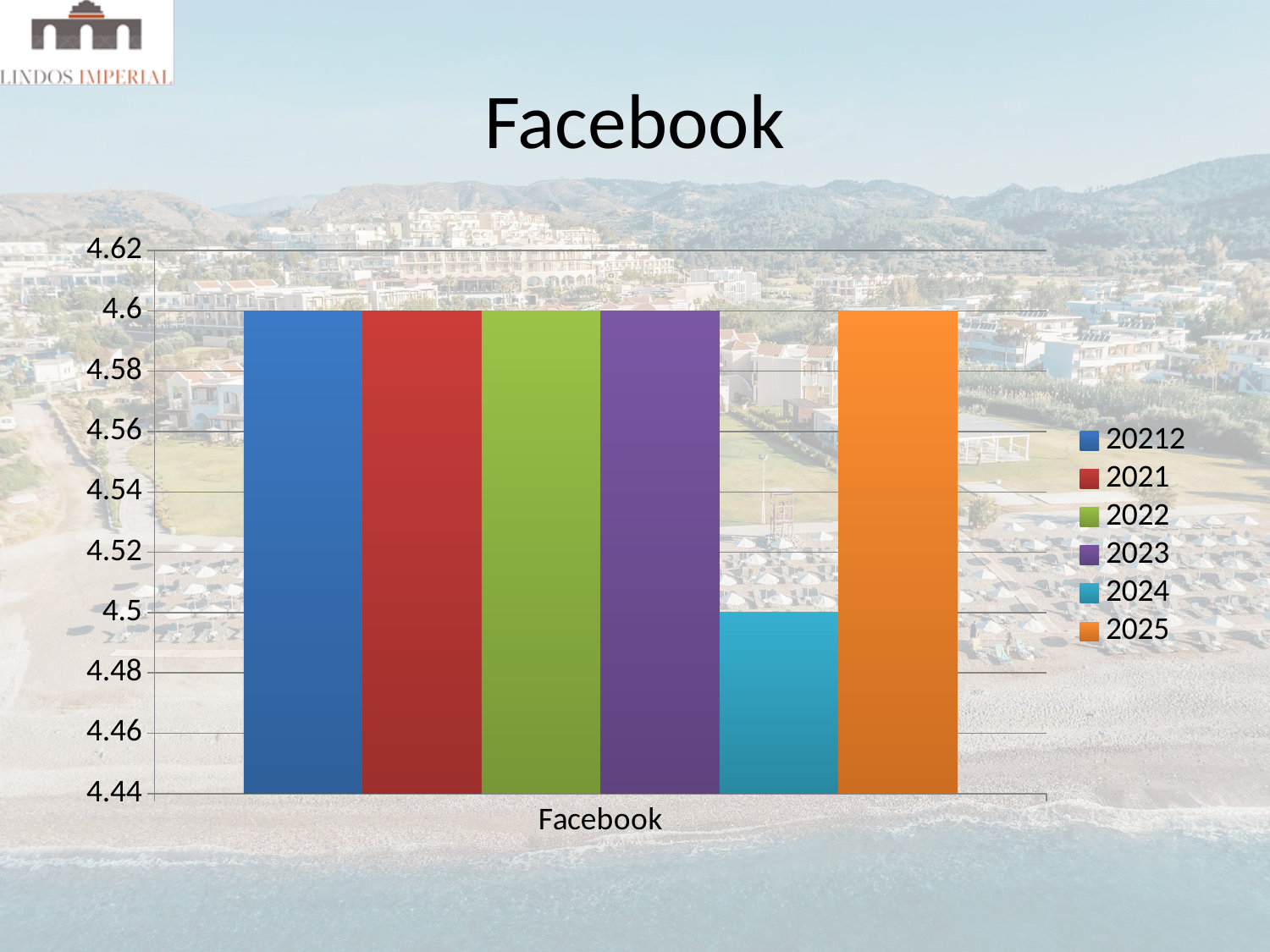
What is the first entry listed in the legend? 20212 What is the difference between the values for 2025 and 2024? 0.1 What is the value for the 2024 series? 4.5 What is the value for the 2025 series? 4.6 What is the value for the 2021 series? 4.6 Which is larger, the value for 2023 or the value for 2024? 2023 Which series has the lowest value? 2024 How many series does the legend list? 6 What kind of chart is shown on the slide? bar chart Is the value for 2024 greater or less than 4.56? less How many categories are shown on the x axis? 1 What is the title of the chart? Facebook